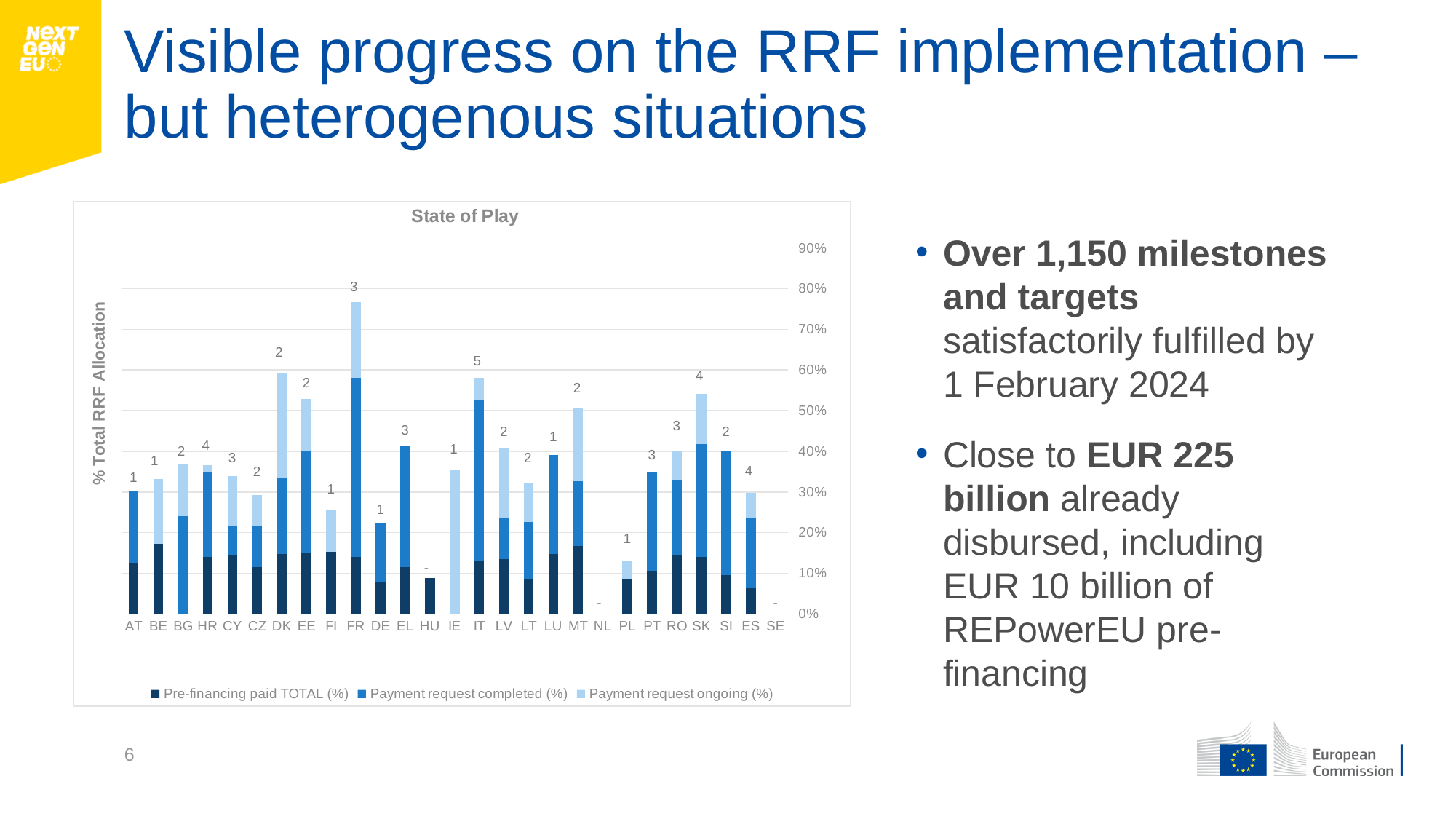
Which has the taller stacked bar, FR or IT? FR Which country has the tallest stacked bar in the chart? FR Is the total stacked value for FR greater or less than 70%? greater How many series does the chart legend list? 3 What number is printed above the bar for IT? 5 What is the title of the chart? State of Play What number is printed above the bar for SK? 4 What kind of chart is shown on the slide? Stacked bar chart What is the label on the vertical axis of the chart? % Total RRF Allocation Is the total stacked value for DK greater or less than 50%? greater Is the total stacked value for HU greater or less than 10%? less How many countries are shown on the x axis of the chart? 27